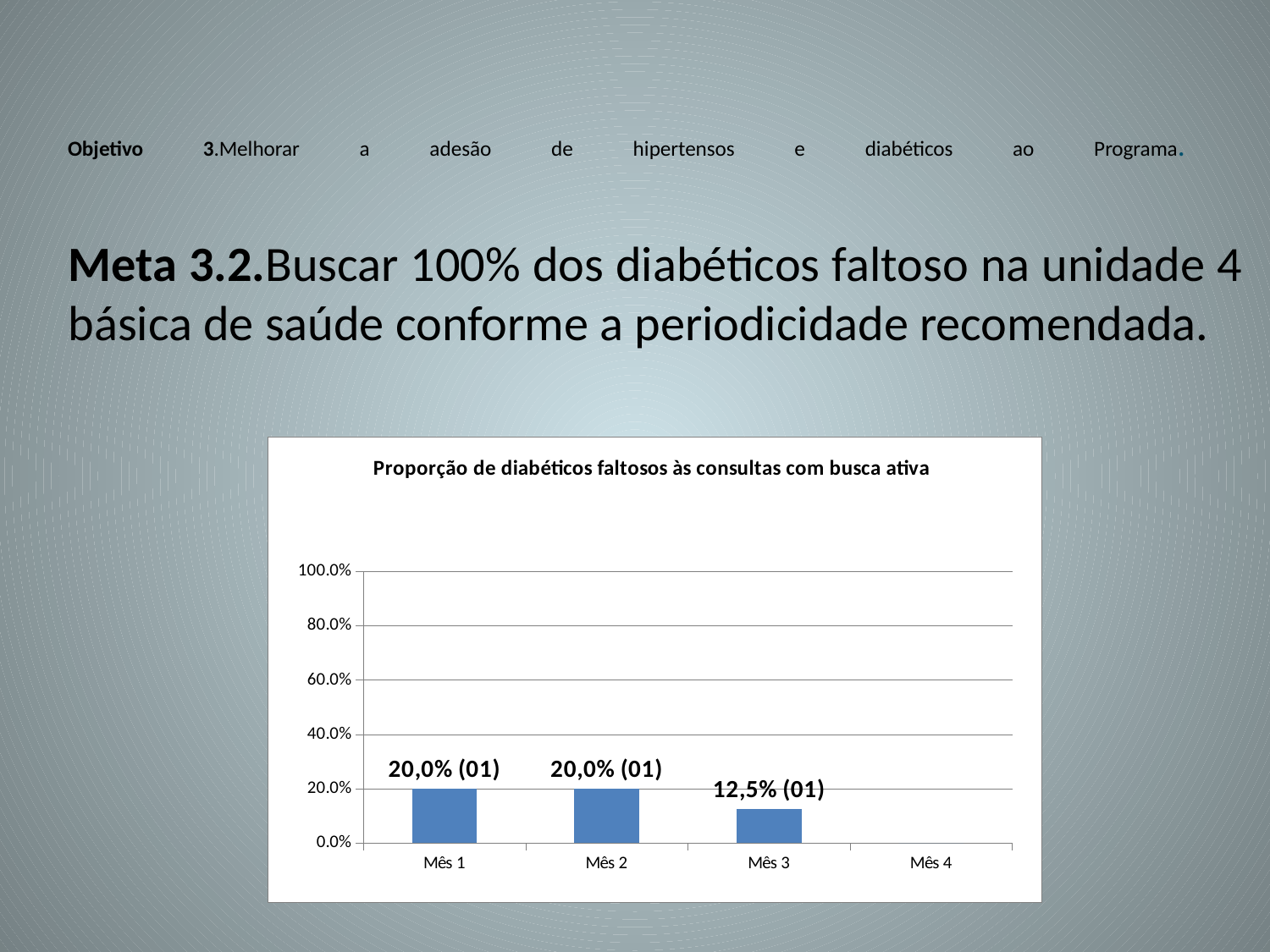
What is the value shown for Mês 3 in the chart? 12,5% (01) What is the difference in percentage points between the value for Mês 2 and the value for Mês 3? 7,5% Which is larger, the value for Mês 1 or the value for Mês 3? Mês 1 What is the value shown for Mês 1 in the chart? 20,0% (01) Is the value for Mês 1 greater or less than 40.0%? less Do the values rise or fall from Mês 2 to Mês 3? fall How many month categories are shown on the x axis? 4 Which month category has no bar plotted? Mês 4 What is the value shown for Mês 2 in the chart? 20,0% (01) Which month has the lowest labelled value among the plotted bars? Mês 3 What is the title of the chart? Proporção de diabéticos faltosos às consultas com busca ativa What kind of chart is shown on the slide? bar chart